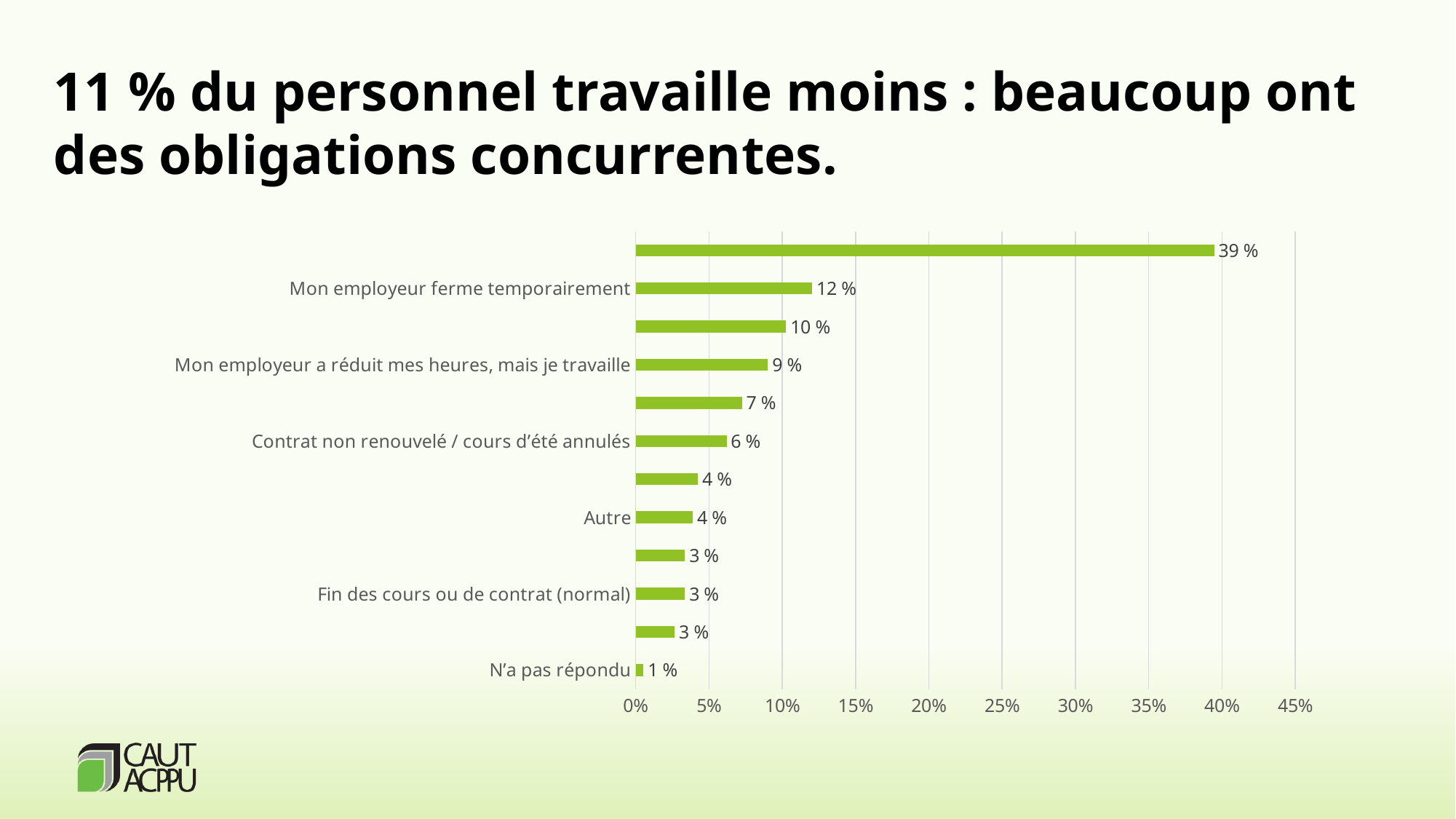
What is the value for "Contrat non renouvelé / cours d'été annulés"? 6 % What is the value for "N'a pas répondu"? 1 % What is the value for "Mon employeur a réduit mes heures, mais je travaille"? 9 % What is the value for "Fin des cours ou de contrat (normal)"? 3 % Which is larger, "Mon employeur ferme temporairement" or "Autre"? Mon employeur ferme temporairement What is the value for "Mon employeur ferme temporairement"? 12 % What type of chart is shown on the slide? bar chart How many bars are plotted on the chart? 12 What is the difference between "Mon employeur ferme temporairement" and "Mon employeur a réduit mes heures, mais je travaille"? 3 % What is the value for "Autre"? 4 % What is the largest value shown on the chart? 39 % Which labelled category has the lowest value? N'a pas répondu